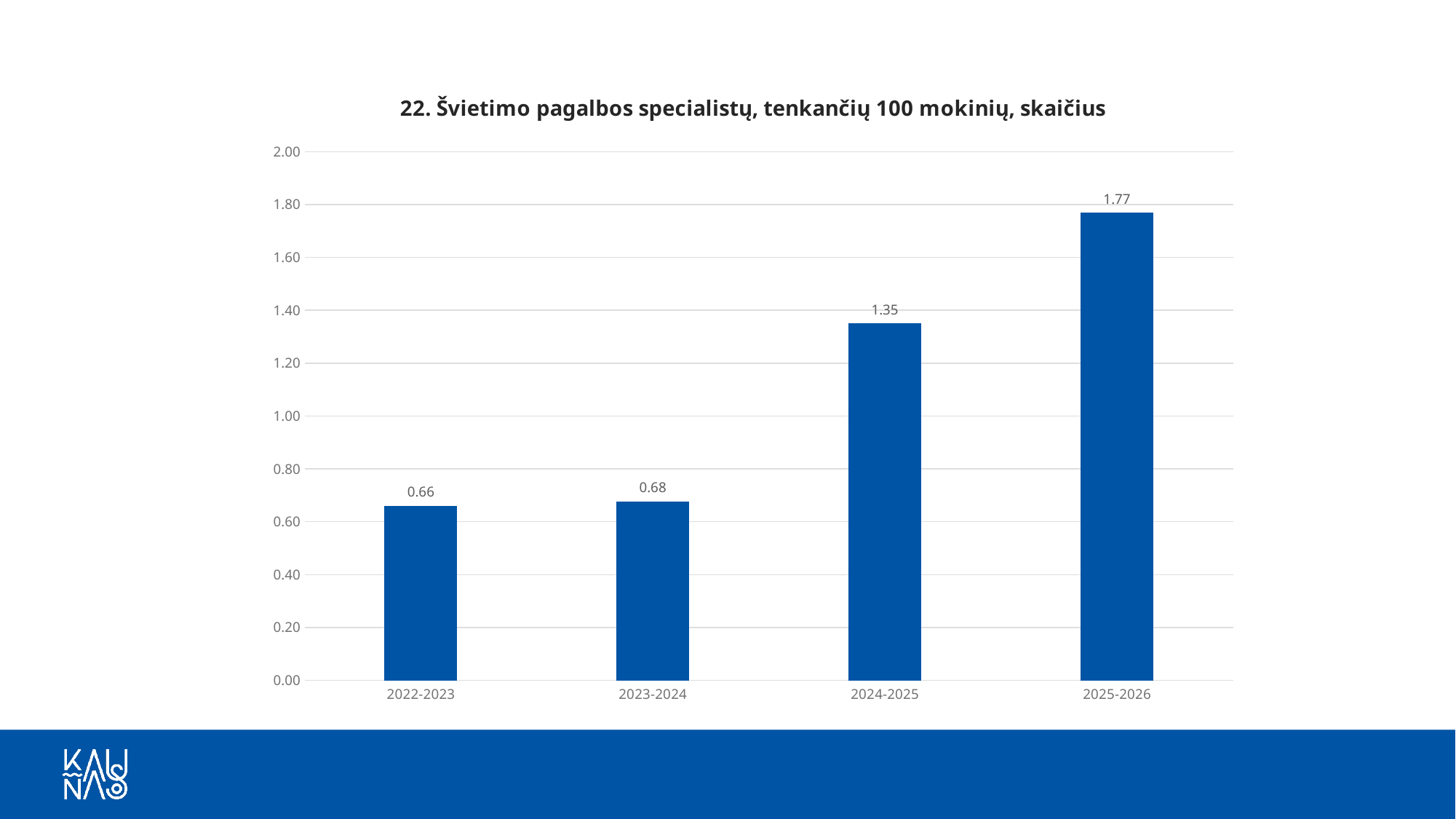
What kind of chart is shown on the slide? bar chart What is the difference between the values for 2023-2024 and 2022-2023? 0.02 How many school years are shown on the x axis? 4 Do the values rise or fall from 2022-2023 to 2025-2026? rise Which school year has the highest value? 2025-2026 What is the value for 2024-2025? 1.35 Which is larger, the value for 2024-2025 or the value for 2023-2024? 2024-2025 What is the value for 2022-2023? 0.66 What is the value for 2025-2026? 1.77 Is the value for 2024-2025 greater or less than 1.20? greater Which school year has the lowest value? 2022-2023 What is the difference between the values for 2025-2026 and 2024-2025? 0.42